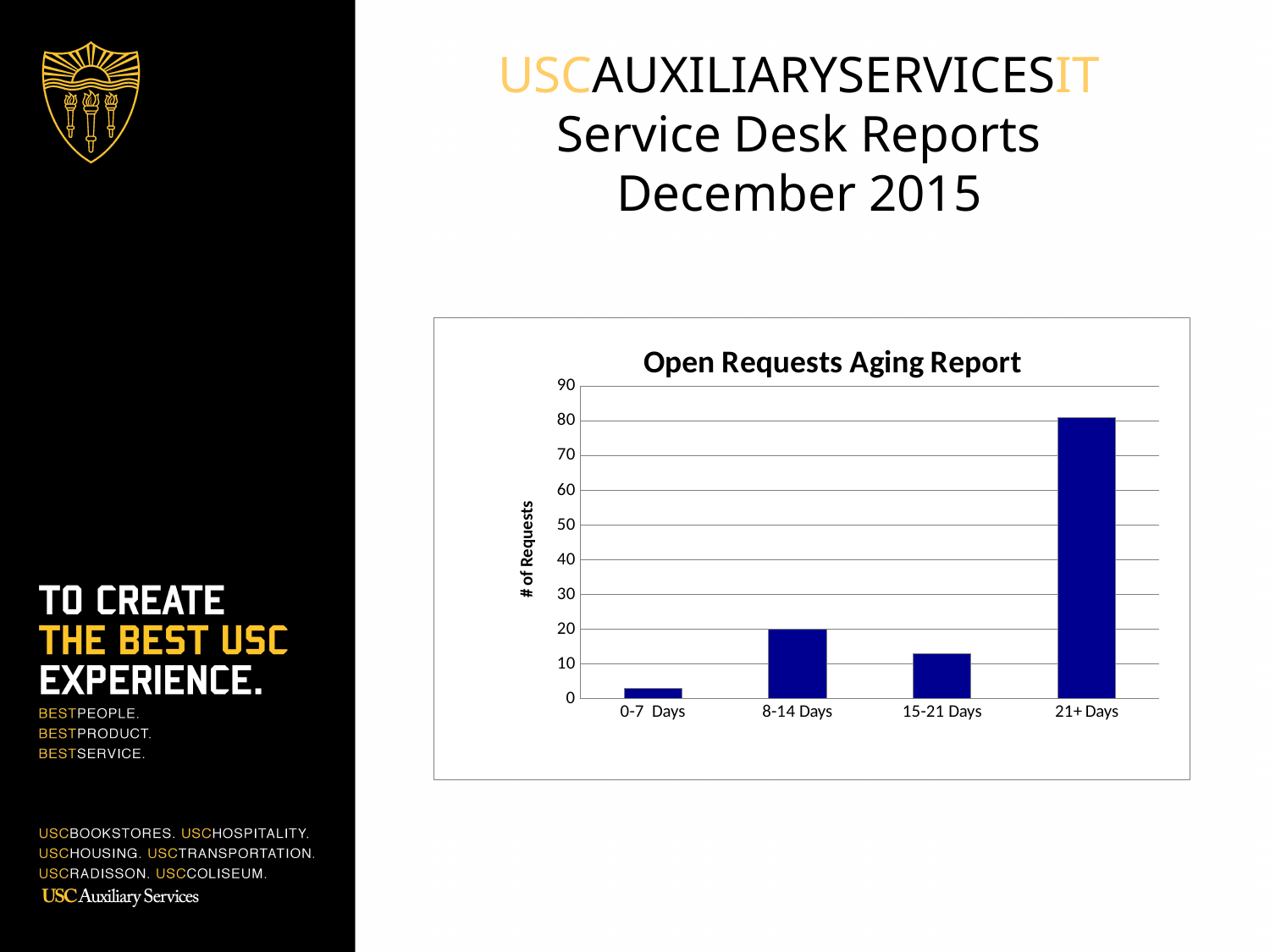
Is the value for 0-7 Days greater or less than 10? less Which has more requests, 21+ Days or 8-14 Days? 21+ Days What kind of chart is shown on the slide? bar chart What is the label of the vertical axis of the chart? # of Requests Which category has the highest number of requests? 21+ Days How many categories are shown on the x axis of the chart? 4 Which has more requests, 8-14 Days or 15-21 Days? 8-14 Days Which category has the lowest number of requests? 0-7 Days Is the value for 15-21 Days greater or less than 10? greater Is the value for 8-14 Days greater or less than 30? less What is the title of the chart? Open Requests Aging Report